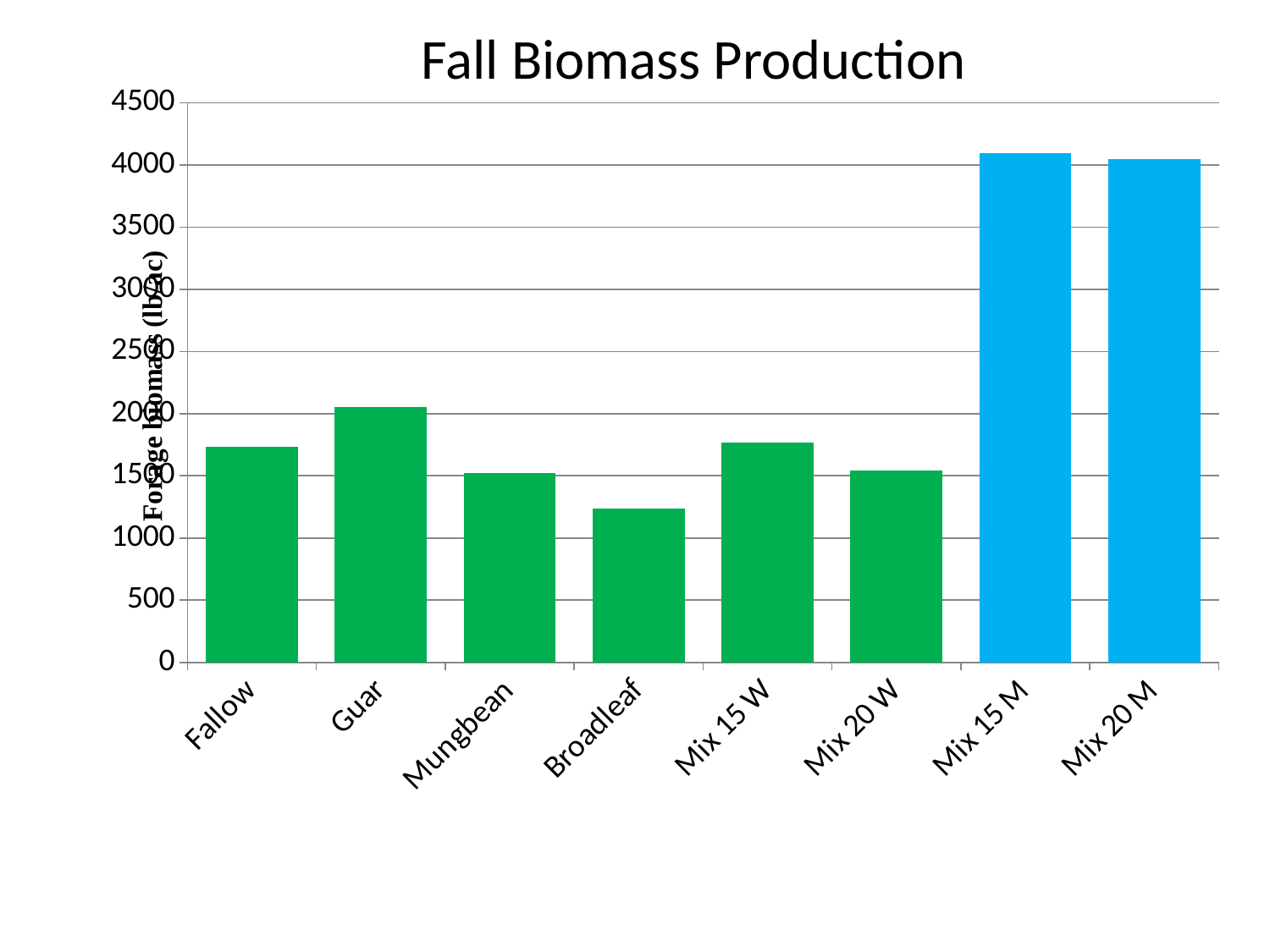
Is the value for Fallow greater or less than 2000? less Which two categories are shown with blue bars instead of green? Mix 15 M and Mix 20 M Is the value for Mix 15 M greater or less than 3500? greater Is the value for Mix 15 W greater or less than 1500? greater Which has a higher value, Guar or Fallow? Guar How many categories are shown on the x axis of the chart? 8 Which category has the lowest fall biomass production? Broadleaf What is the title of the chart? Fall Biomass Production What kind of chart is shown on the slide? bar chart Which has a higher value, Mix 15 M or Mix 20 W? Mix 15 M Which has a higher value, Mungbean or Broadleaf? Mungbean